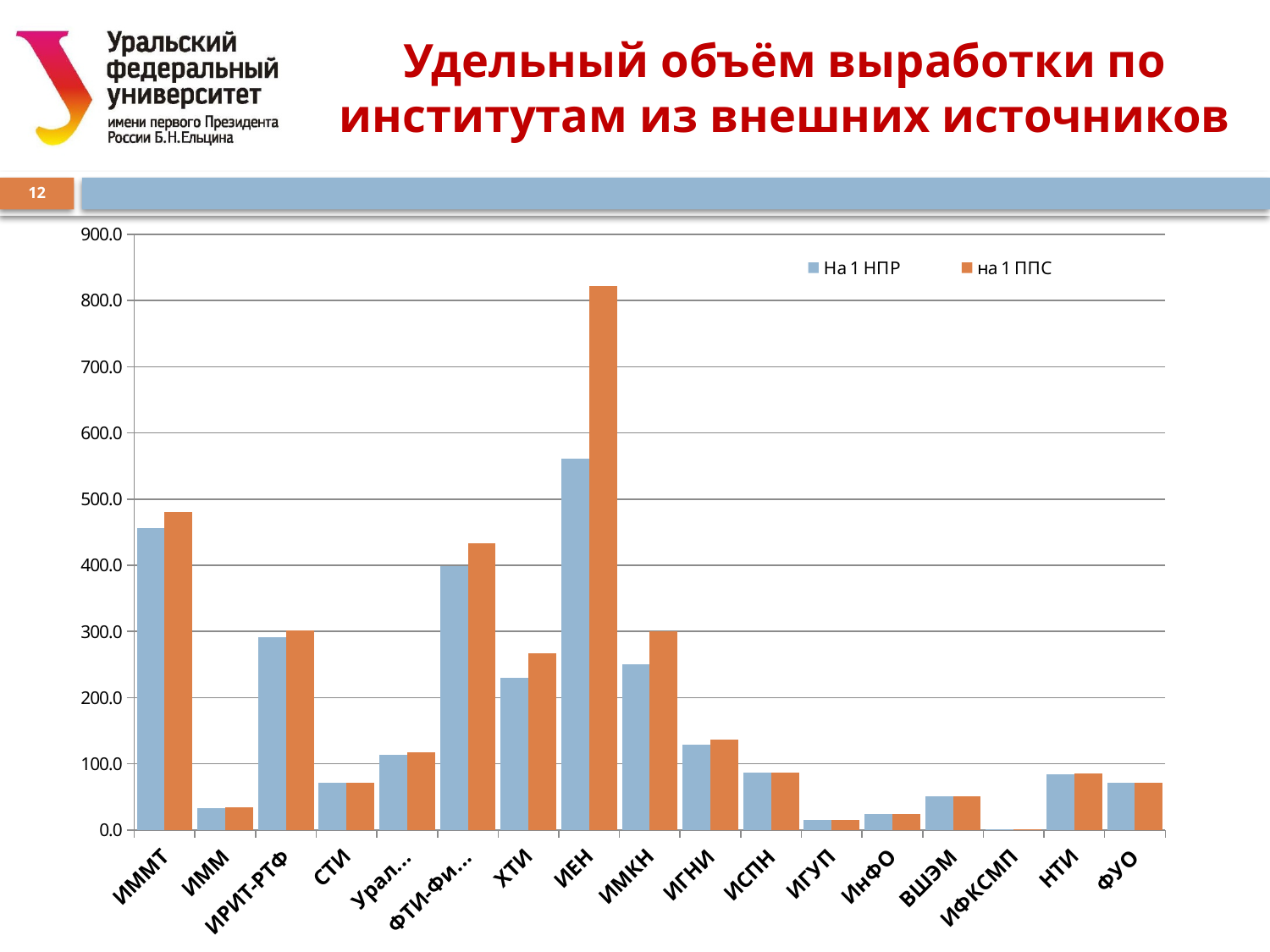
How many institutes (categories) are shown on the x axis? 17 How many series does the legend list? 2 Is the 'на 1 ППС' value for ИСПН greater or less than 100? less Which institute has the lowest values in the chart? ИФКСМП What kind of chart is shown on the slide? bar chart Is the 'на 1 ППС' value for ИЕН greater or less than 800? greater Which institute has the highest value for the series 'на 1 ППС'? ИЕН Is the 'На 1 НПР' value for ИММТ greater or less than 400? greater What are the two legend entries of the chart? На 1 НПР and на 1 ППС For the series 'На 1 НПР', which is larger: ИММ or ИГУП? ИММ Which institute has the highest value for the series 'На 1 НПР'? ИЕН